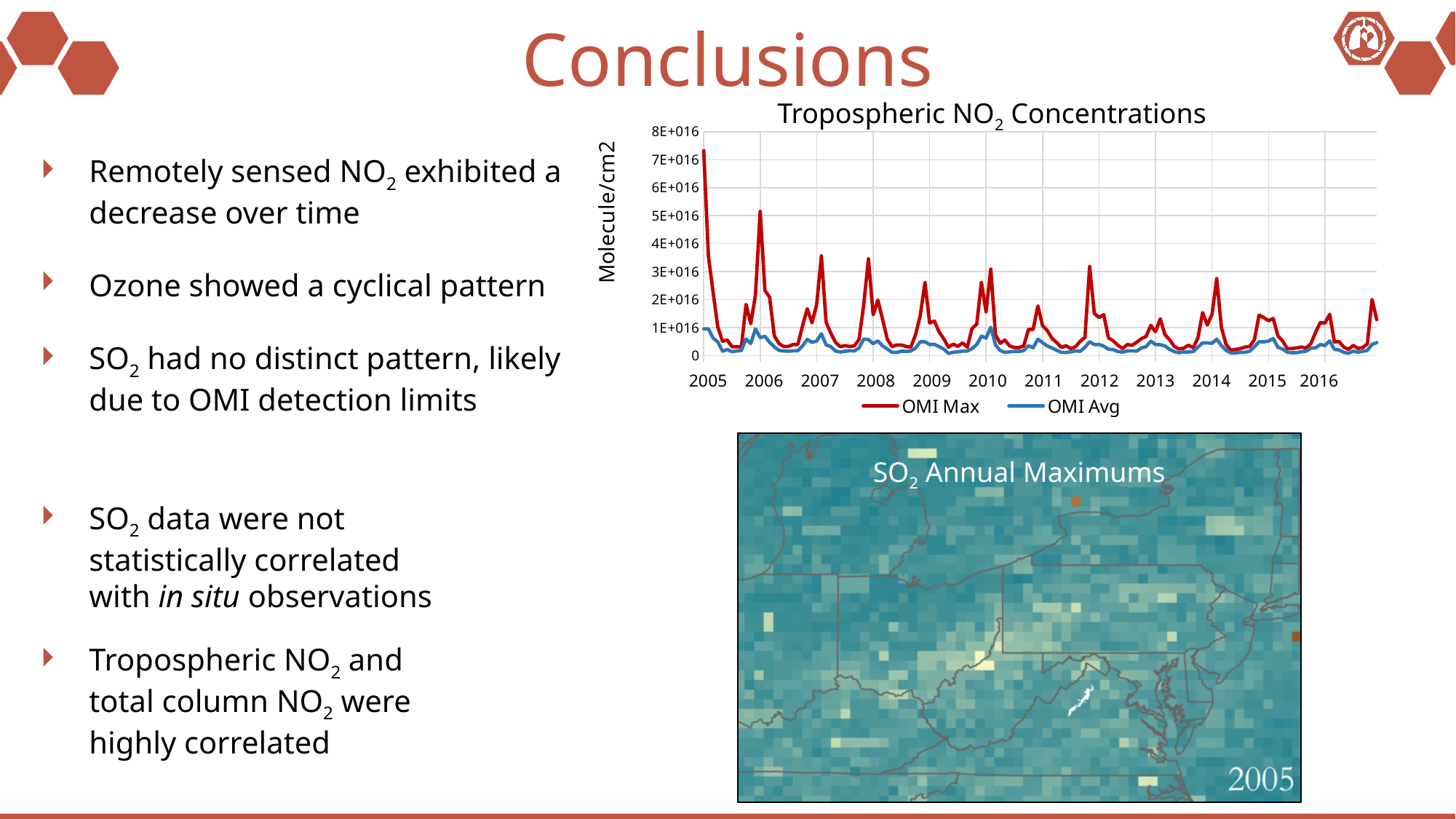
What is the y-axis label of the Tropospheric NO2 Concentrations chart? Molecule/cm2 In the Tropospheric NO2 Concentrations chart, is the highest OMI Max value in 2005 greater or less than 6E+016? greater What are the two series named in the legend of the Tropospheric NO2 Concentrations chart? OMI Max and OMI Avg In the Tropospheric NO2 Concentrations chart, do the OMI Max peaks generally rise or fall from 2005 to 2016? fall How many series does the legend of the Tropospheric NO2 Concentrations chart list? 2 In the Tropospheric NO2 Concentrations chart, is the OMI Avg series ever greater than 2E+016? No What kind of chart is the Tropospheric NO2 Concentrations chart? line chart In the Tropospheric NO2 Concentrations chart, in which year does the OMI Max series reach its highest value? 2005 In the Tropospheric NO2 Concentrations chart, is the OMI Max peak in 2014 greater or less than 2E+016? greater How many year labels are shown on the x axis of the Tropospheric NO2 Concentrations chart? 12 In the Tropospheric NO2 Concentrations chart, which series has the higher values overall, OMI Max or OMI Avg? OMI Max